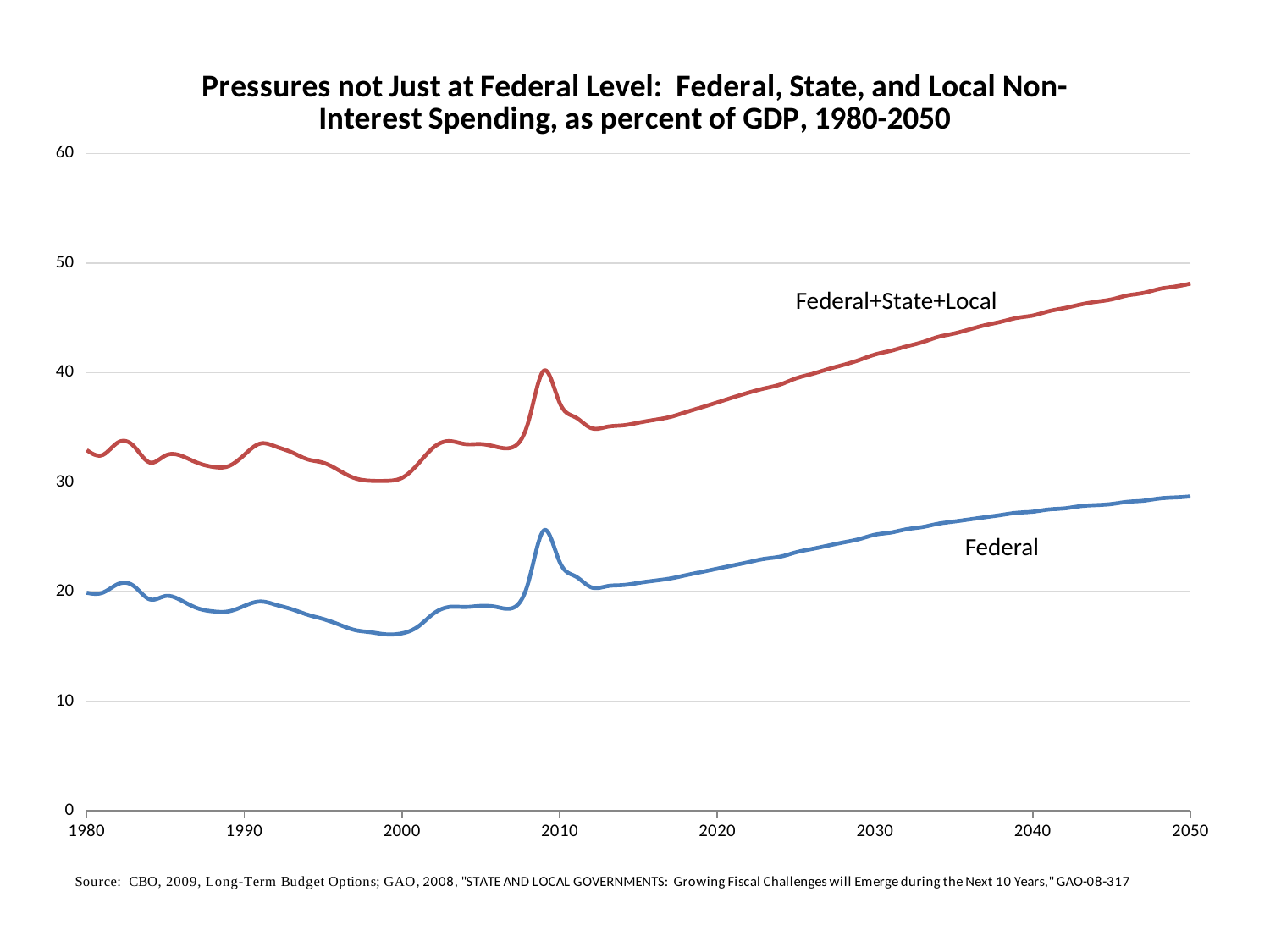
Is the value for Federal+State+Local in 1980 greater or less than 30? greater Is the value for Federal in 2000 greater or less than 20? less Does the Federal line rise or fall between 2020 and 2050? rise How many data series are plotted on the chart? 2 Is the value for Federal+State+Local in 2050 greater or less than 40? greater Which two series are labelled on the chart? Federal+State+Local and Federal What is the range of years shown on the x axis? 1980 to 2050 Which series has the higher value in 2050, Federal+State+Local or Federal? Federal+State+Local What kind of chart is shown on the slide? line chart